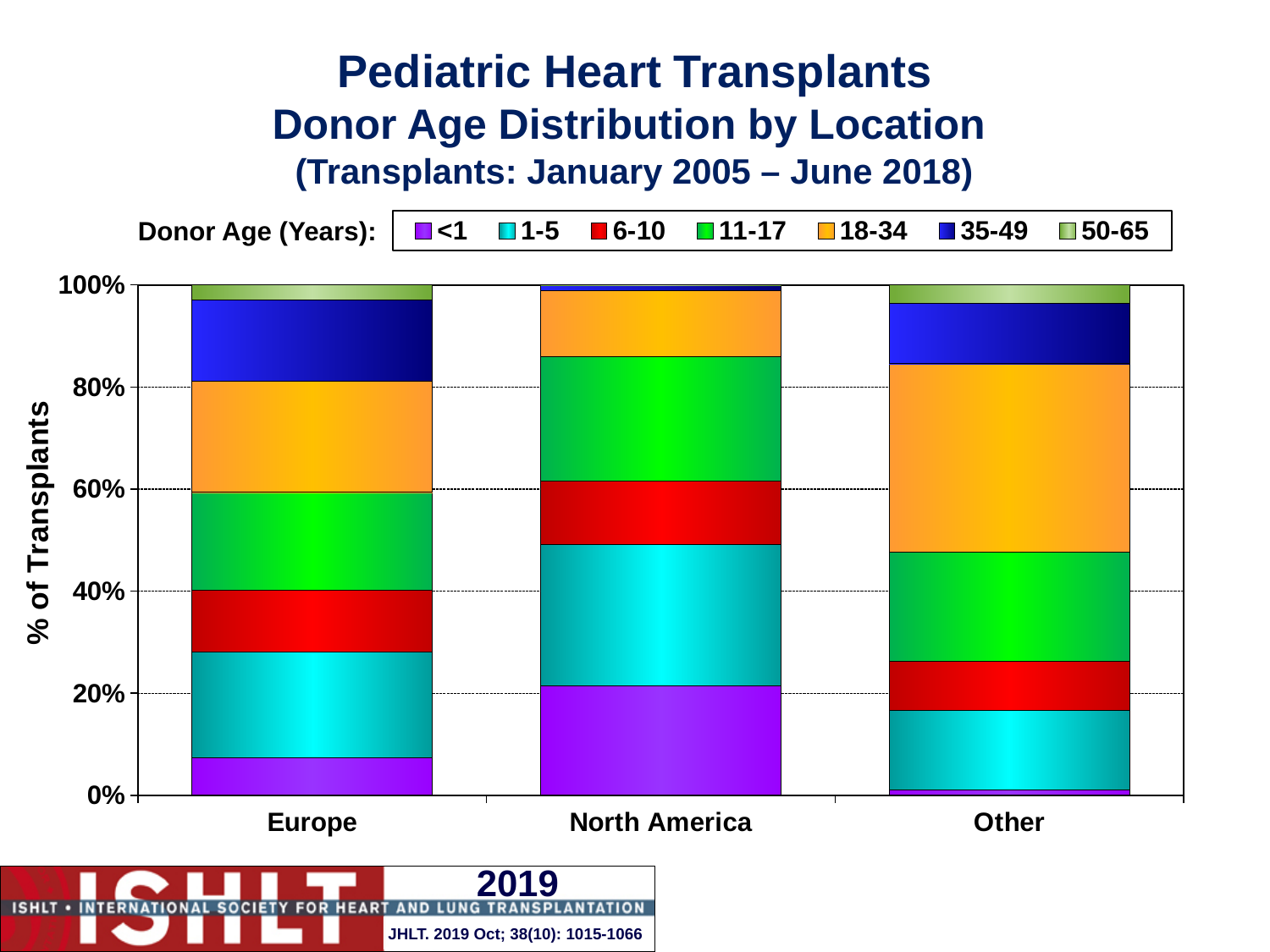
How many donor age groups does the legend list? 7 Which location has the largest share of donors aged 18-34? Other Is the share of donors aged <1 in Europe greater or less than 20%? less Which location has the smallest share of donors aged 35-49? North America Which location has the smallest share of donors aged <1? Other What transplant period is given in the chart title? January 2005 – June 2018 What is the total height of the Europe stacked bar? 100% What type of chart is shown on the slide? Stacked bar chart Is the combined share of donors aged <1 and 1-5 in North America greater or less than 40%? greater Which location has the largest share of donors aged <1? North America How many locations are shown on the x axis of the chart? 3 What is the label of the y axis? % of Transplants